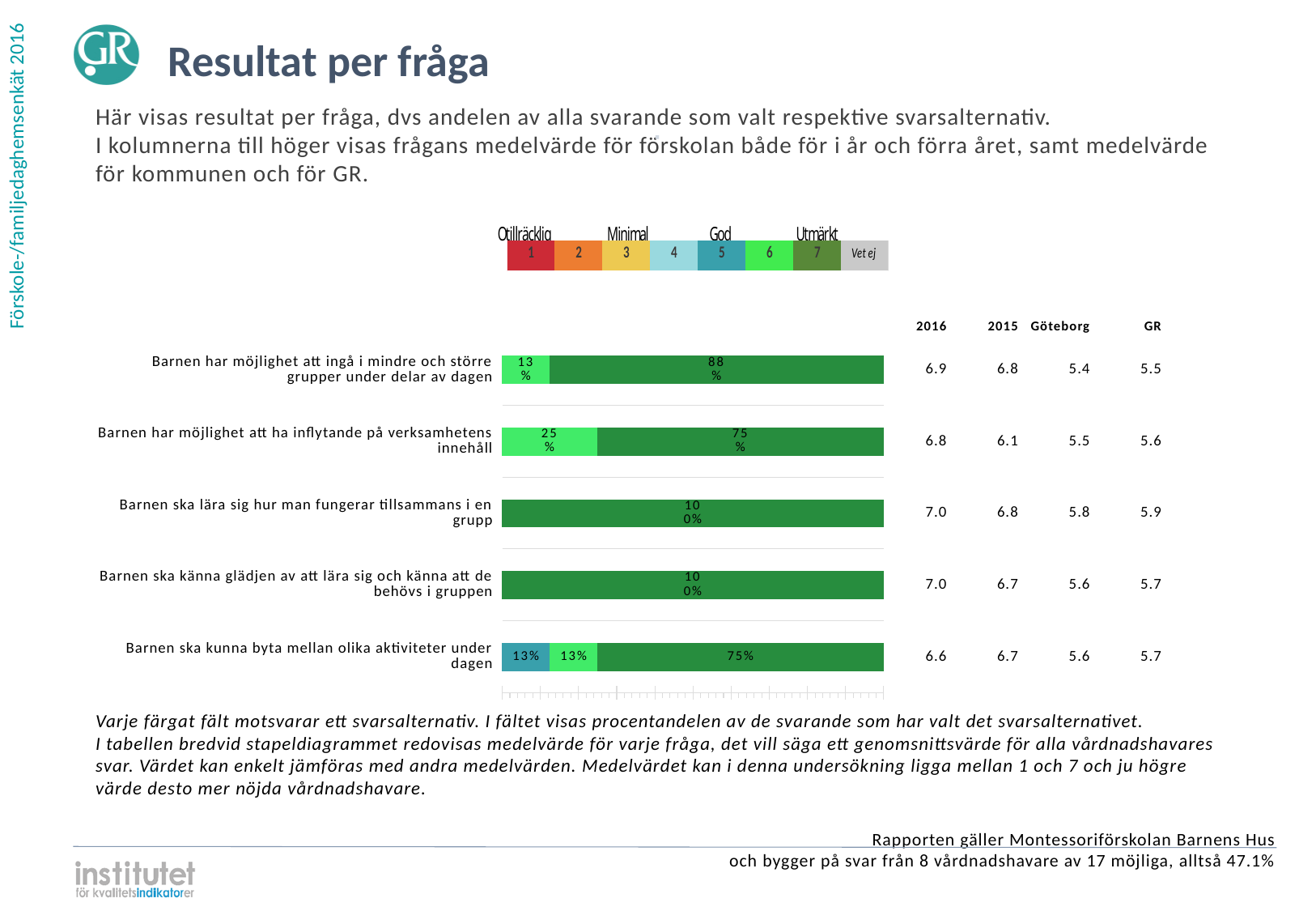
What percentage of respondents chose option 7 (dark green) for "Barnen har möjlighet att ingå i mindre och större grupper under delar av dagen"? 88% What is the difference in percentage points between the option 7 share for "Barnen har möjlighet att ingå i mindre och större grupper under delar av dagen" (88%) and for "Barnen har möjlighet att ha inflytande på verksamhetens innehåll" (75%)? 13 How many questions (categories) are plotted as bars in the chart? 5 What percentage of respondents chose option 7 for "Barnen ska lära sig hur man fungerar tillsammans i en grupp"? 100% How many coloured segments does the bar for "Barnen ska kunna byta mellan olika aktiviteter under dagen" have? 3 How many response options does the legend above the chart list? 8 What label does the legend give to the grey box at the right end of the response scale? Vet ej In the table to the right of the chart, what is the 2016 mean value for "Barnen ska kunna byta mellan olika aktiviteter under dagen"? 6.6 What percentage of respondents chose option 6 (light green) for "Barnen har möjlighet att ha inflytande på verksamhetens innehåll"? 25% What kind of chart is shown on the slide? bar chart What percentage is shown for the teal (option 5) segment of "Barnen ska kunna byta mellan olika aktiviteter under dagen"? 13% Which has a larger option 7 (dark green) share: "Barnen har möjlighet att ingå i mindre och större grupper under delar av dagen" or "Barnen ska kunna byta mellan olika aktiviteter under dagen"? Barnen har möjlighet att ingå i mindre och större grupper under delar av dagen